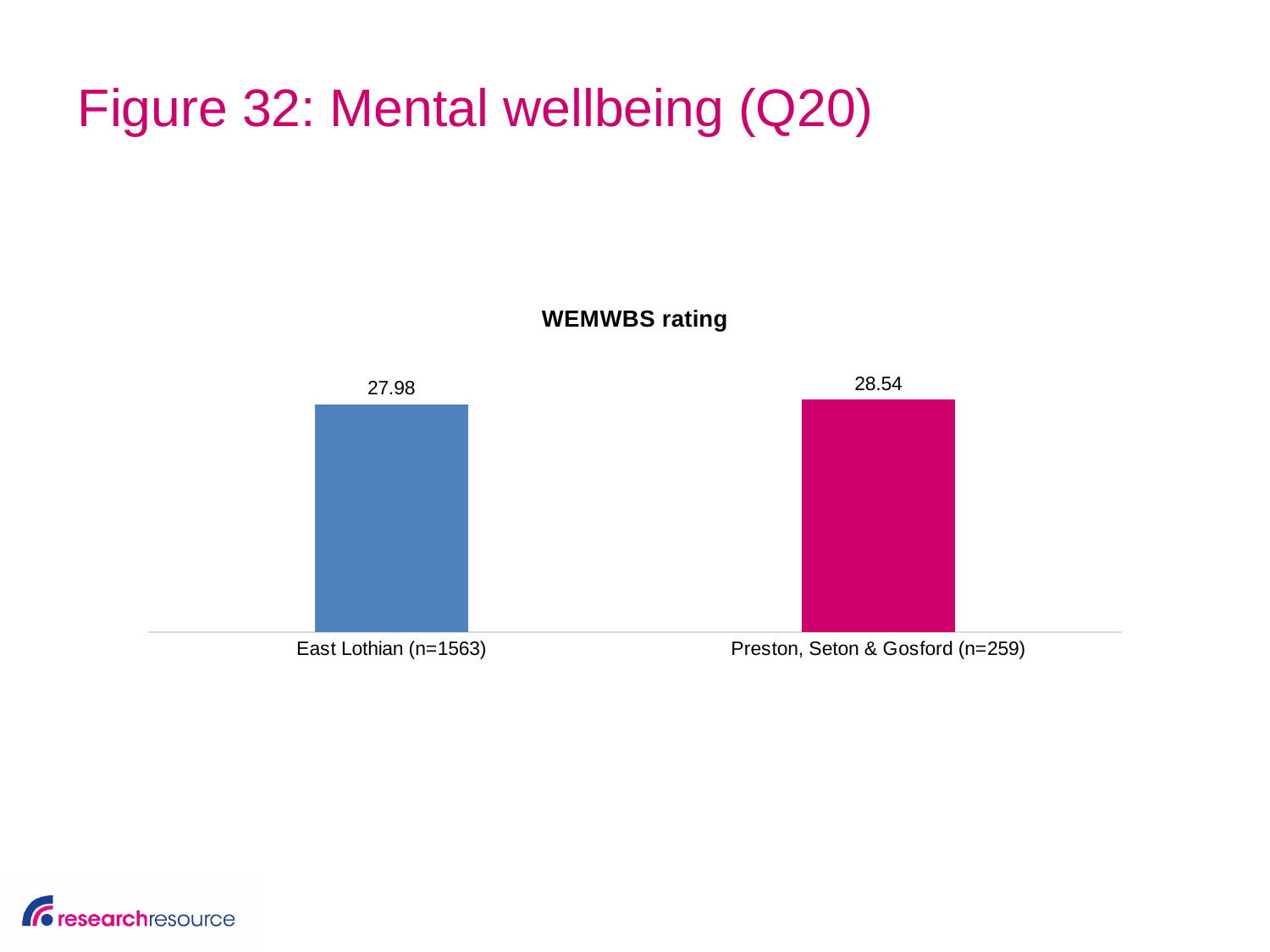
Which category has the higher WEMWBS rating? Preston, Seton & Gosford (n=259) What is the WEMWBS rating for East Lothian (n=1563)? 27.98 What is the title of the chart? WEMWBS rating What colour is the bar for Preston, Seton & Gosford (n=259)? pink/magenta What is the WEMWBS rating for Preston, Seton & Gosford (n=259)? 28.54 What is the difference between the WEMWBS ratings for Preston, Seton & Gosford and East Lothian? 0.56 What is the sample size shown for East Lothian? n=1563 Is the WEMWBS rating for East Lothian larger or smaller than that for Preston, Seton & Gosford? smaller How many categories are shown in the chart? 2 What kind of chart is shown on the slide? bar chart Which category has the lower WEMWBS rating? East Lothian (n=1563) What is the sample size shown for Preston, Seton & Gosford? n=259